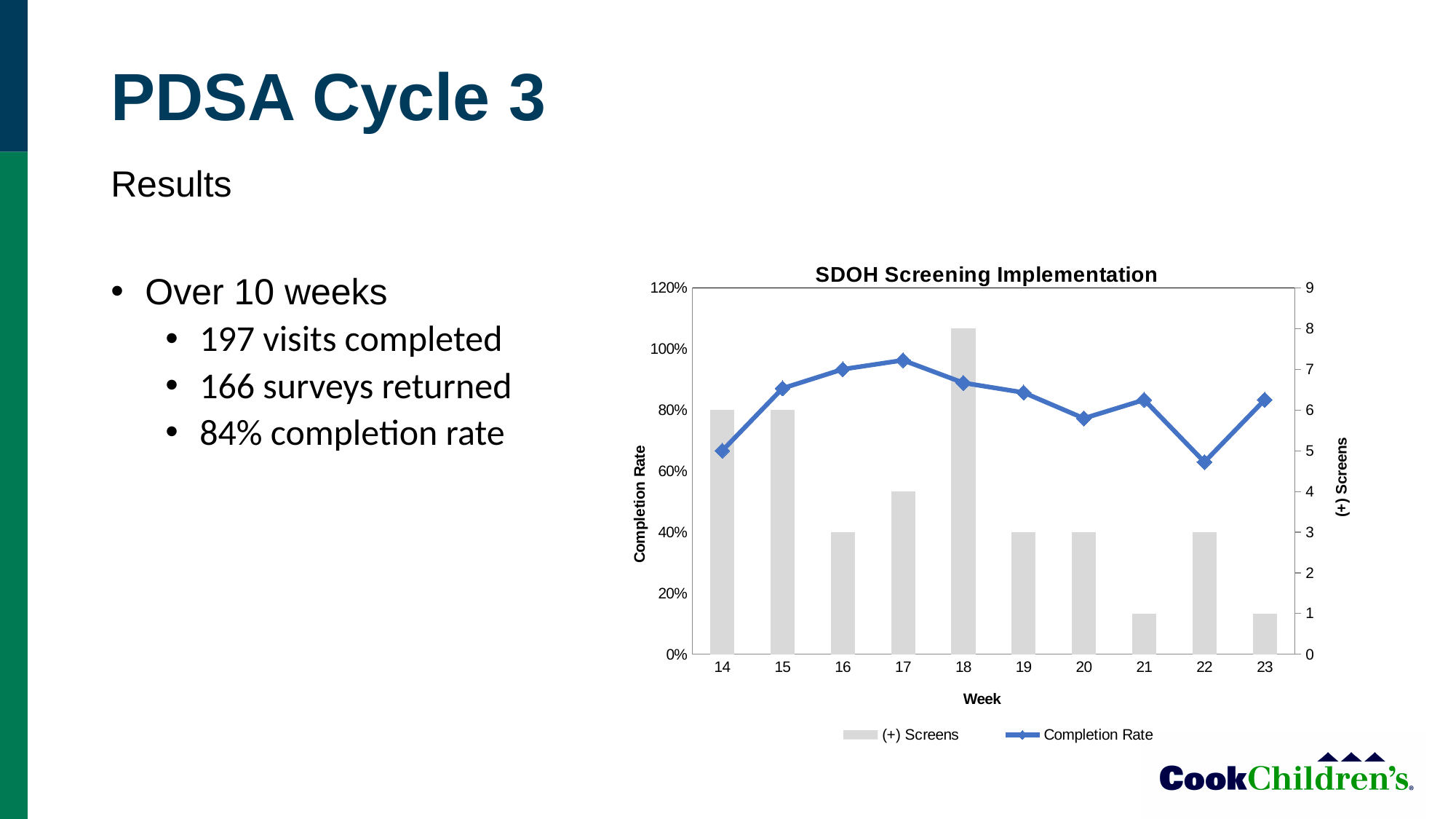
How many (+) Screens were recorded in week 14? 6 What is the difference in (+) Screens between week 18 and week 16? 5 Is the Completion Rate for week 17 greater or less than 80%? greater How many series does the legend of the SDOH Screening Implementation chart list? 2 How many (+) Screens were recorded in week 18? 8 How many weeks are plotted along the x axis of the chart? 10 What is the title of the chart? SDOH Screening Implementation What kind of chart is shown on the slide? A combination bar and line chart Which has more (+) Screens, week 17 or week 21? Week 17 Which week has the lowest Completion Rate? Week 22 Is the Completion Rate for week 22 greater or less than 80%? less Which week has the highest number of (+) Screens? Week 18